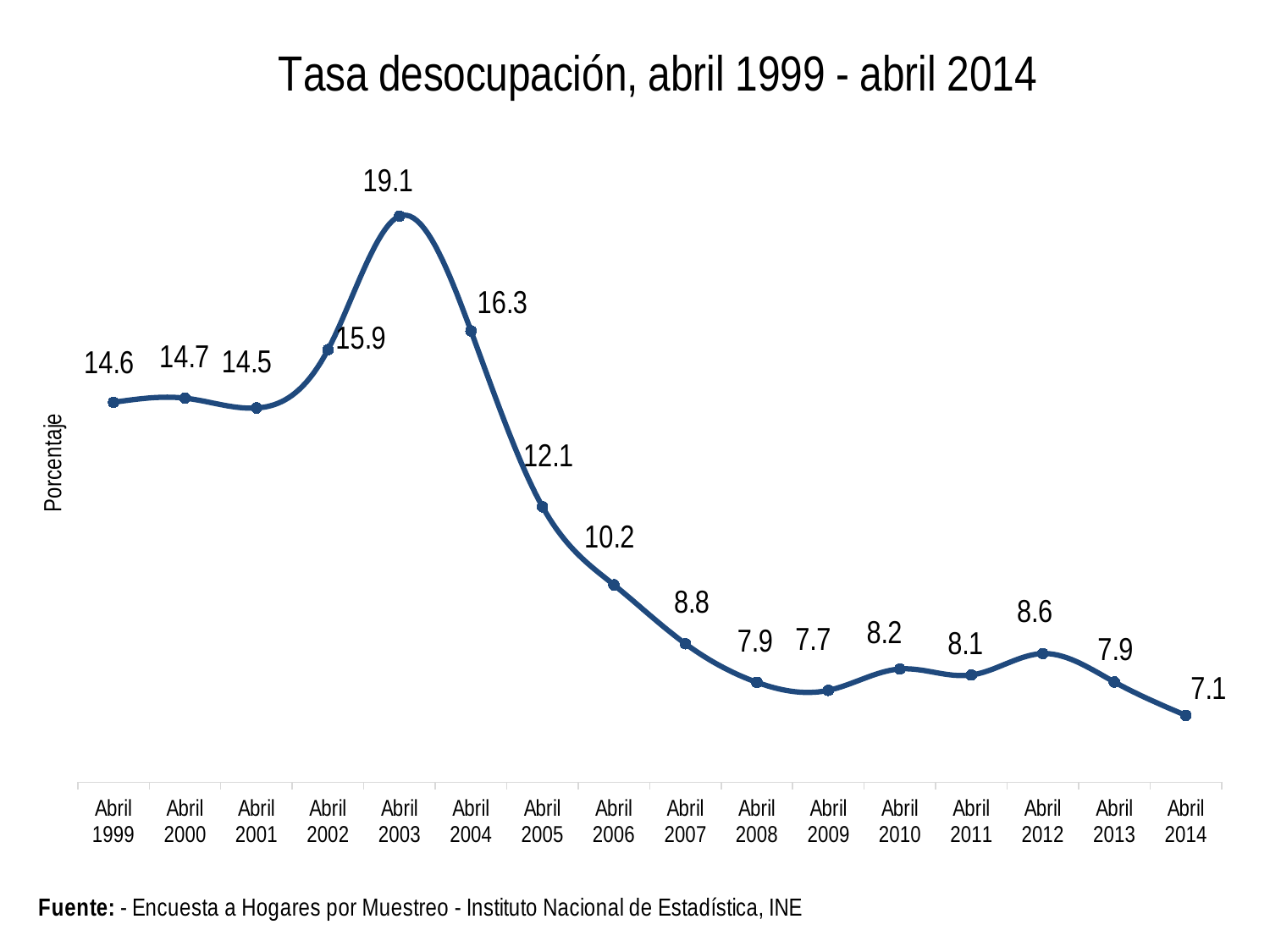
Which point has the highest value? Abril 2003 What is the difference between the values for Abril 2003 and Abril 2004? 2.8 Which is larger, the value for Abril 2010 or the value for Abril 2011? Abril 2010 What is the value for Abril 2014? 7.1 What is the difference between the values for Abril 1999 and Abril 2014? 7.5 What kind of chart is this? line chart How many data points are plotted on the chart? 16 What is the value for Abril 2005? 12.1 Which point has the lowest value? Abril 2014 Do the values rise or fall from Abril 2003 to Abril 2009? fall What is the title of the chart? Tasa desocupación, abril 1999 - abril 2014 What is the value for Abril 2003? 19.1